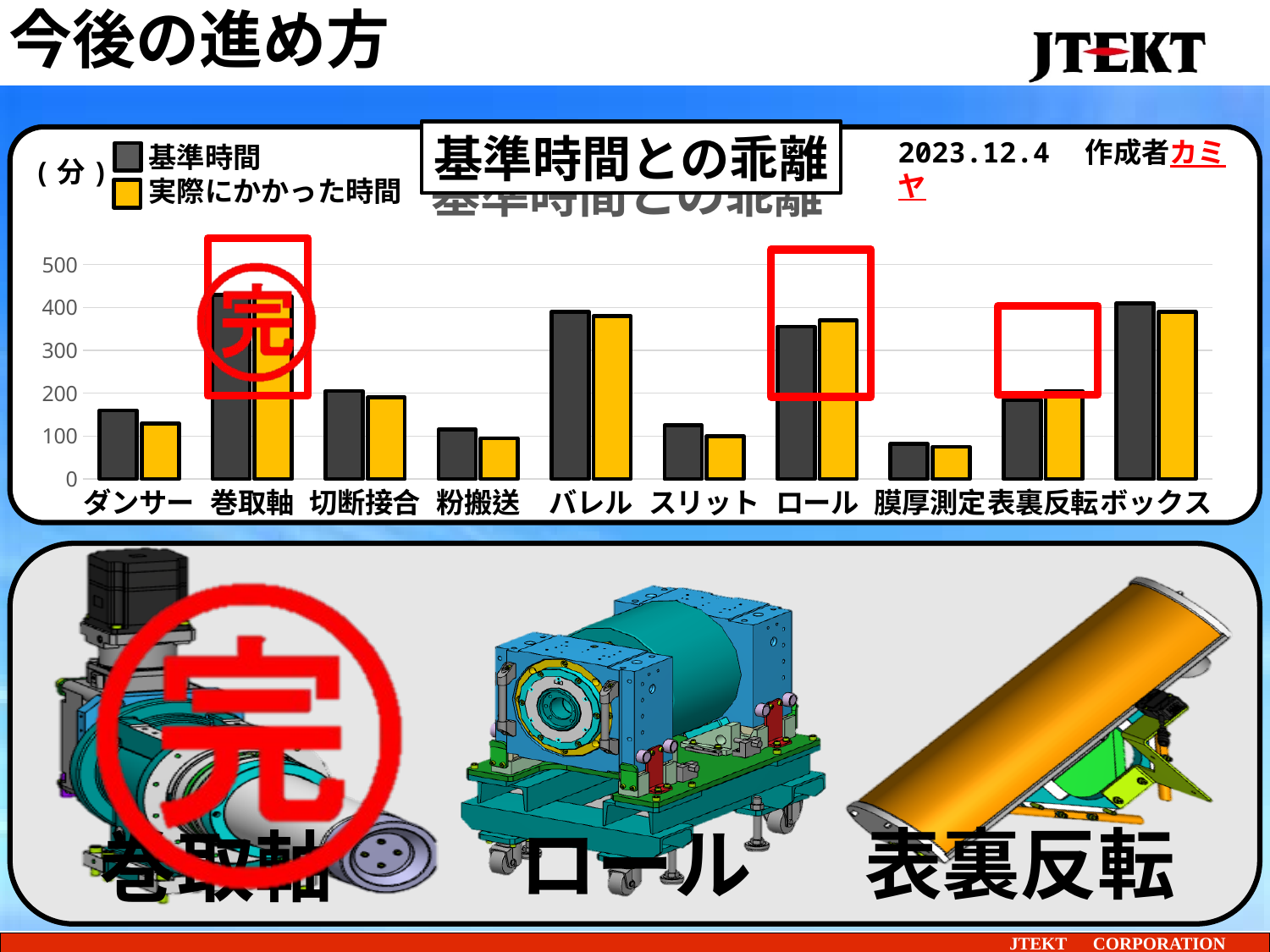
Is the 基準時間 value for ダンサー greater or less than 100? greater What unit is shown for the chart's values? 分 Is the 基準時間 value for 膜厚測定 greater or less than 100? less What kind of chart is shown on the slide? bar chart Is the 実際にかかった時間 value for バレル greater or less than 300? greater Which category has the lowest 基準時間 value? 膜厚測定 Which category has the lowest 実際にかかった時間 value? 膜厚測定 For ダンサー, which is larger: 基準時間 or 実際にかかった時間? 基準時間 What is the title of the chart? 基準時間との乖離 How many series does the chart legend list? 2 How many categories are shown along the x axis of the chart? 10